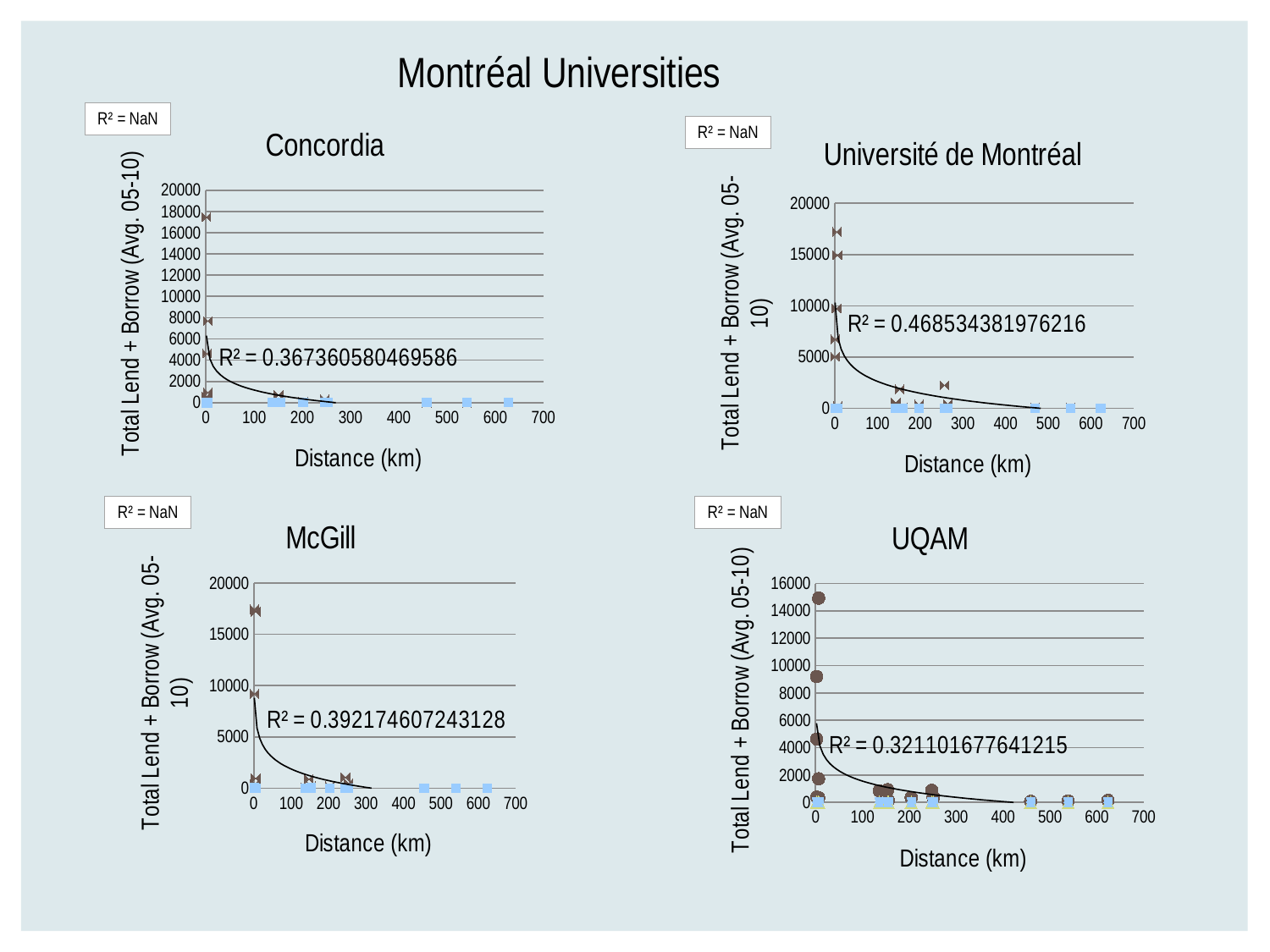
In the UQAM chart, is the highest plotted value greater or less than 16000? less In the UQAM chart, do the plotted values rise or fall as distance increases? fall How many charts are shown on the slide? 4 What kind of chart is the Concordia chart? scatter chart Which of the four charts shows the highest R² value? Université de Montréal In the Concordia chart, is the highest plotted value greater or less than 16000? greater What is the R² value printed on the Université de Montréal chart? 0.468534381976216 What is the R² value printed on the Concordia chart? 0.367360580469586 What is the x-axis title on the McGill chart? Distance (km) Which of the four charts shows the lowest R² value? UQAM What is the R² value printed on the McGill chart? 0.392174607243128 What is the R² value printed on the UQAM chart? 0.321101677641215